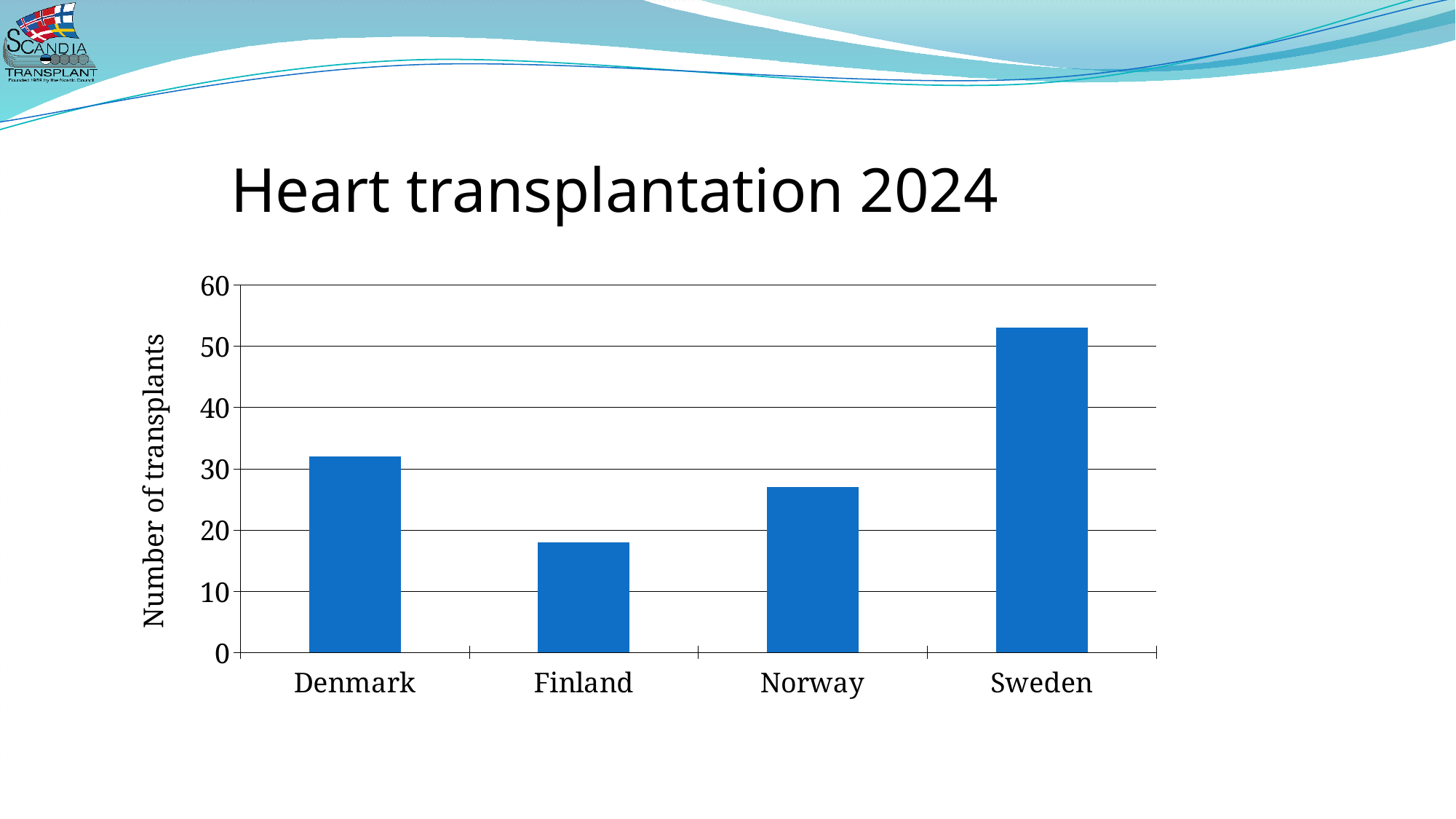
What is the label of the vertical axis? Number of transplants What is the title of the slide? Heart transplantation 2024 Is the value for Denmark greater or less than 30? greater Which country has the highest number of heart transplants in the chart? Sweden How many countries are shown in the chart? 4 Which has more heart transplants, Denmark or Norway? Denmark Which country has the lowest number of heart transplants in the chart? Finland Is the value for Finland greater or less than 20? less Is the value for Norway greater or less than 30? less What kind of chart is shown on the slide? Bar chart Which has more heart transplants, Finland or Sweden? Sweden